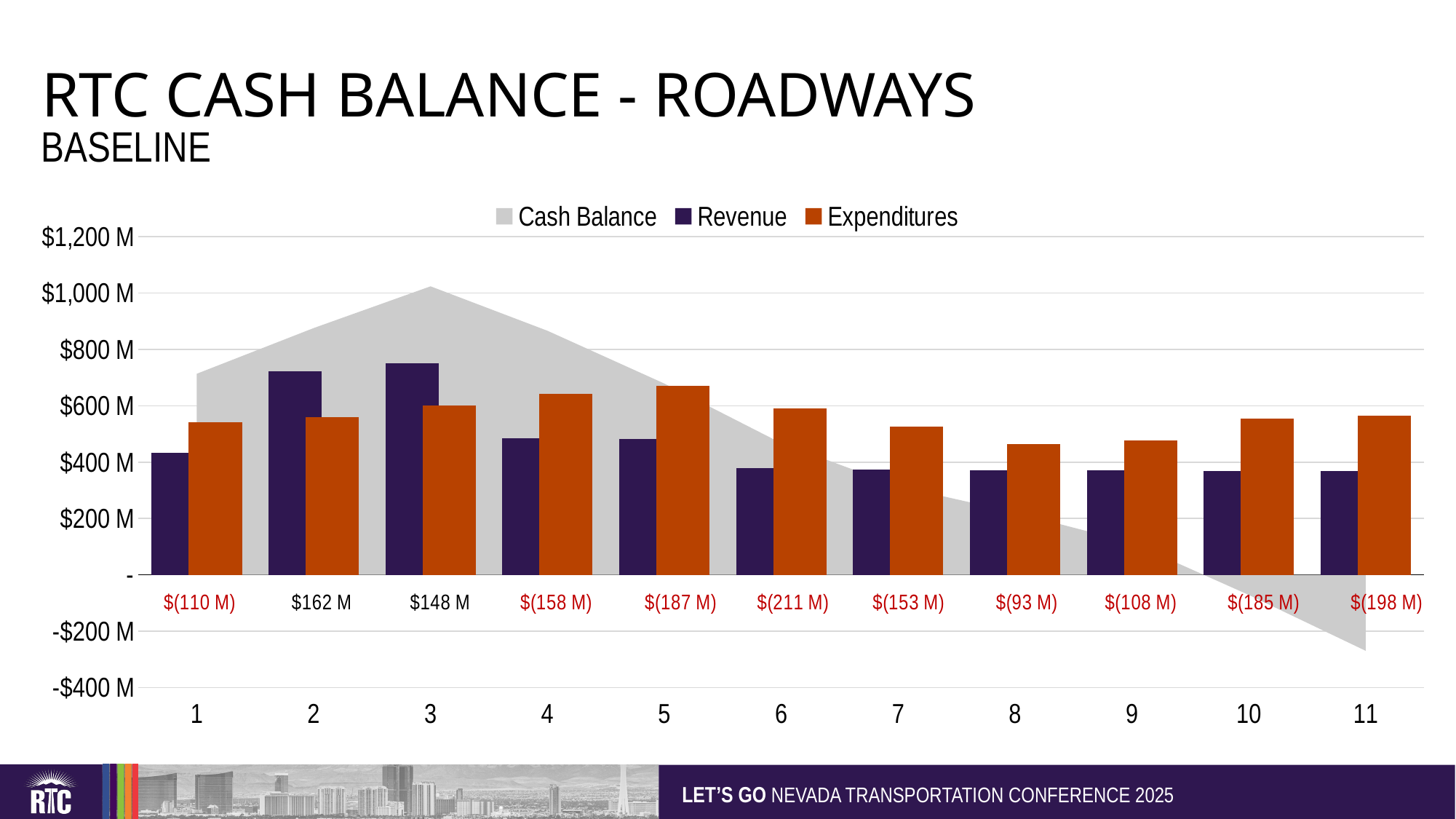
What value is printed below period 11? $(198 M) How many periods are shown along the x axis? 11 Is the Expenditures value for period 8 greater or less than $600 M? less What value is printed below period 6? $(211 M) Is the Revenue value for period 2 greater or less than $600 M? greater What kind of chart is shown on the slide? combination bar and area chart What value is printed below period 2? $162 M In period 1, which is larger, Revenue or Expenditures? Expenditures Does the Cash Balance rise or fall from period 3 to period 11? fall How many series does the legend list? 3 In which period is Expenditures highest? 5 In which period is Revenue highest? 3